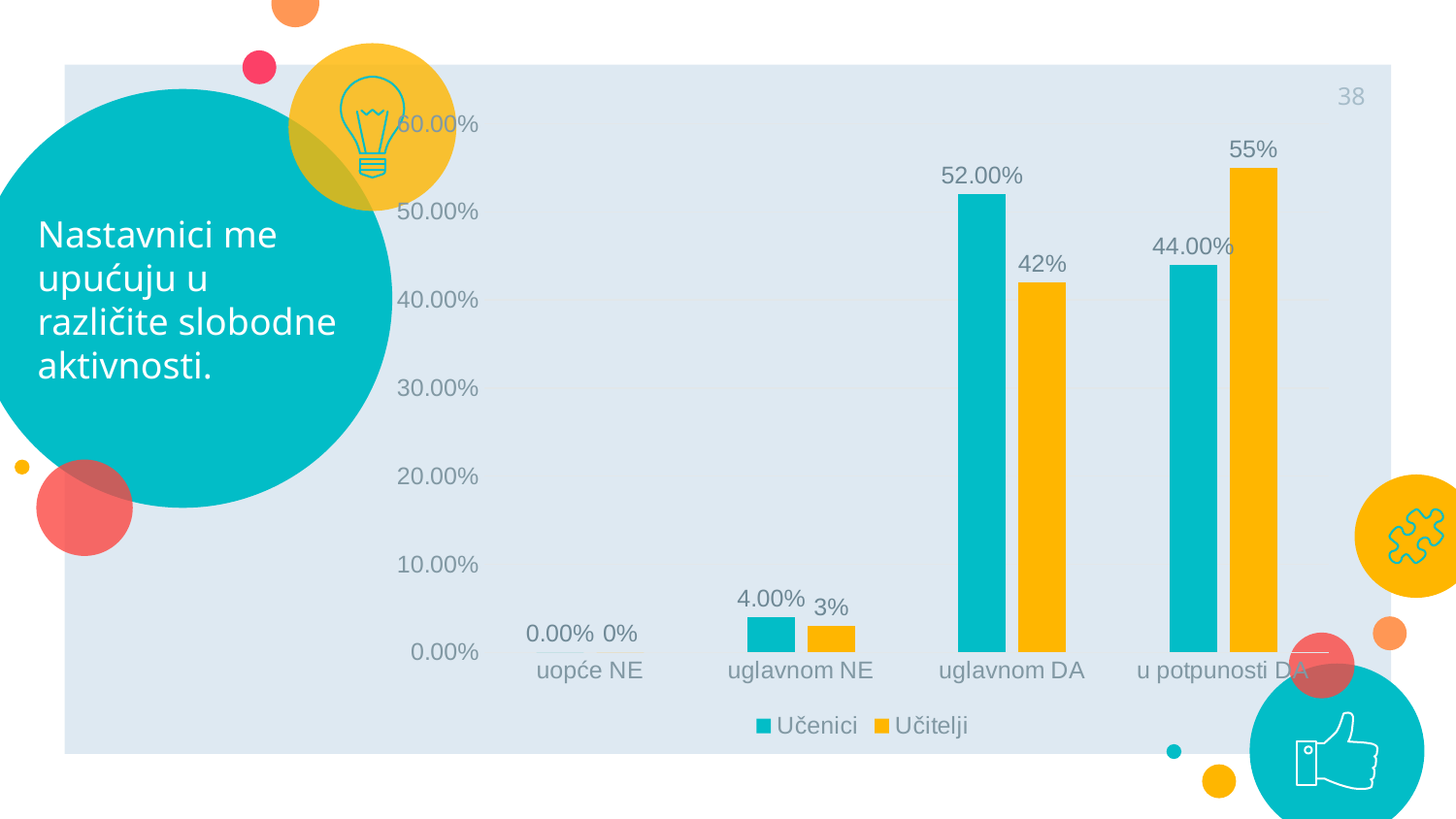
In the category uglavnom DA, which series has the larger value, Učenici or Učitelji? Učenici What is the value for Učitelji in the category uglavnom NE? 3% How many categories are shown on the x axis? 4 Which category has the highest value for Učenici? uglavnom DA What is the difference between the Učitelji and Učenici values in the category u potpunosti DA? 11 percentage points What kind of chart is shown on the slide? bar chart Which category has the highest value for Učitelji? u potpunosti DA Which series is shown in orange in the legend? Učitelji How many series does the legend list? 2 What is the value for Učenici in the category uglavnom NE? 4.00% What is the value for Učenici in the category uglavnom DA? 52.00% What is the value for Učitelji in the category u potpunosti DA? 55%